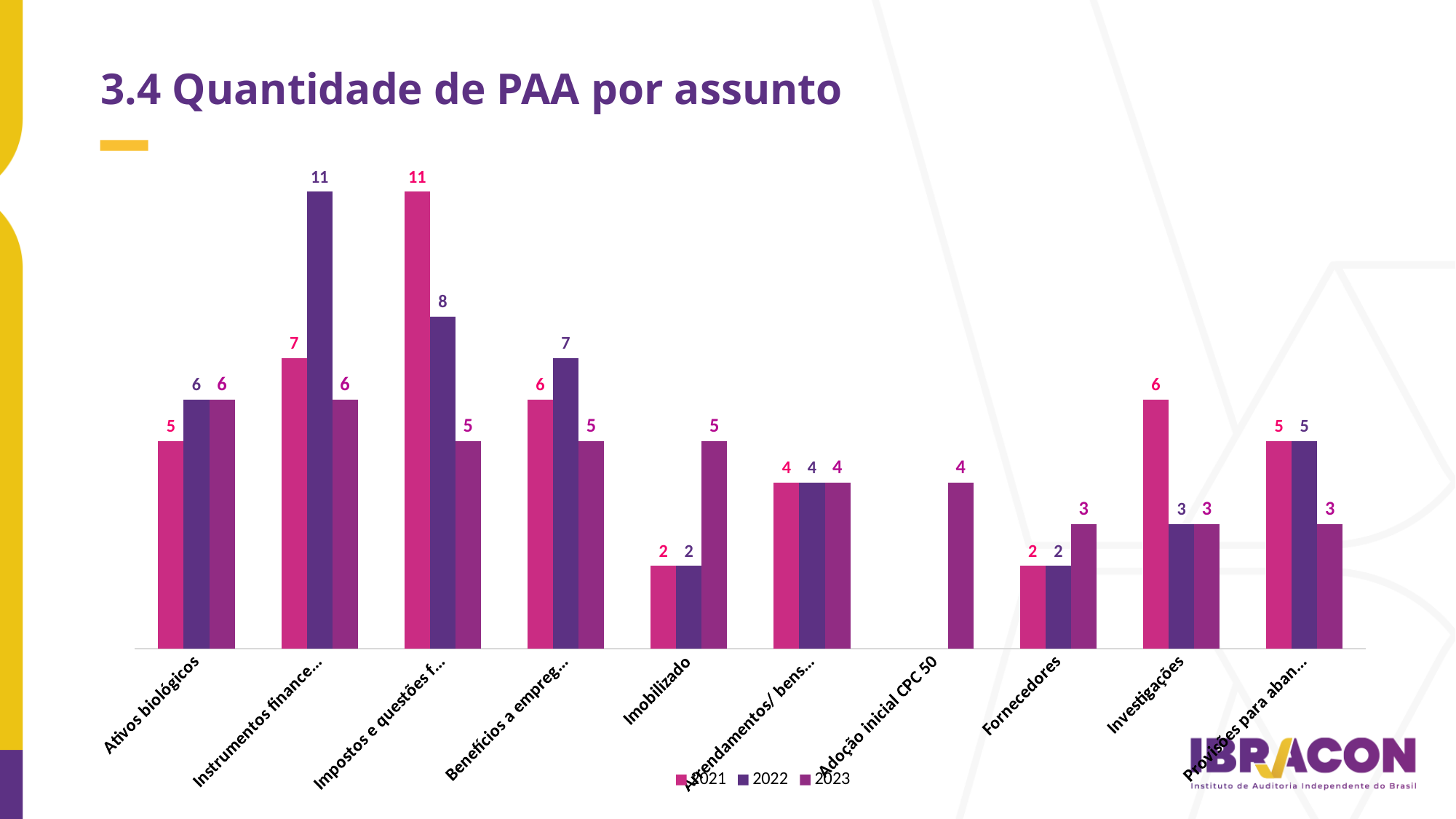
What kind of chart is shown on the slide? Bar chart What is the value for Fornecedores in 2023? 3 Which category has the highest value in the 2022 series? Instrumentos finance... What is the difference between the 2021 and 2022 values for Investigações? 3 Which is larger for Imobilizado: the 2021 value or the 2023 value? 2023 What is the value for Ativos biológicos in 2021? 5 Which category has the lowest value in the 2021 series? Imobilizado and Fornecedores (both 2) How many series does the legend list? 3 Which series are listed in the legend? 2021, 2022, 2023 What is the value for Imobilizado in 2023? 5 What is the value for Investigações in 2021? 6 How many categories are shown on the x axis? 10